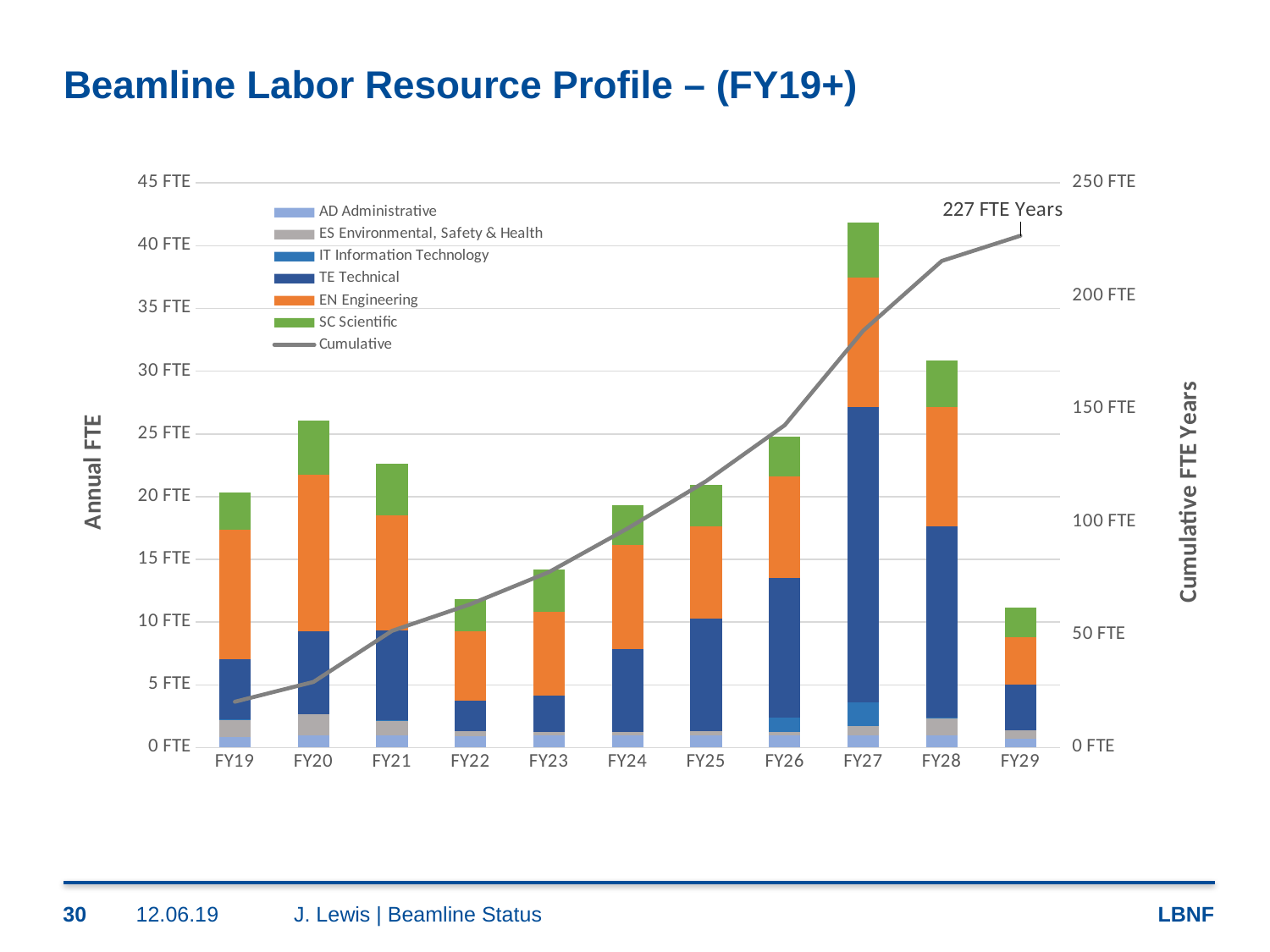
How many series does the legend list? 7 Is the total stacked bar for FY20 greater or less than 25 FTE? greater Is the total stacked bar for FY23 greater or less than 15 FTE? less Which fiscal year has the tallest stacked bar? FY27 Which has the taller stacked bar, FY20 or FY21? FY20 Does the Cumulative line rise or fall from FY19 to FY29? rises What is the label of the right-hand vertical axis? Cumulative FTE Years How many fiscal years are shown on the x axis? 11 What kind of chart is shown on the slide? combination bar and line chart Which has the taller stacked bar, FY28 or FY29? FY28 What cumulative value is labelled at the end of the Cumulative line? 227 FTE Years Is the total stacked bar for FY27 greater or less than 40 FTE? greater